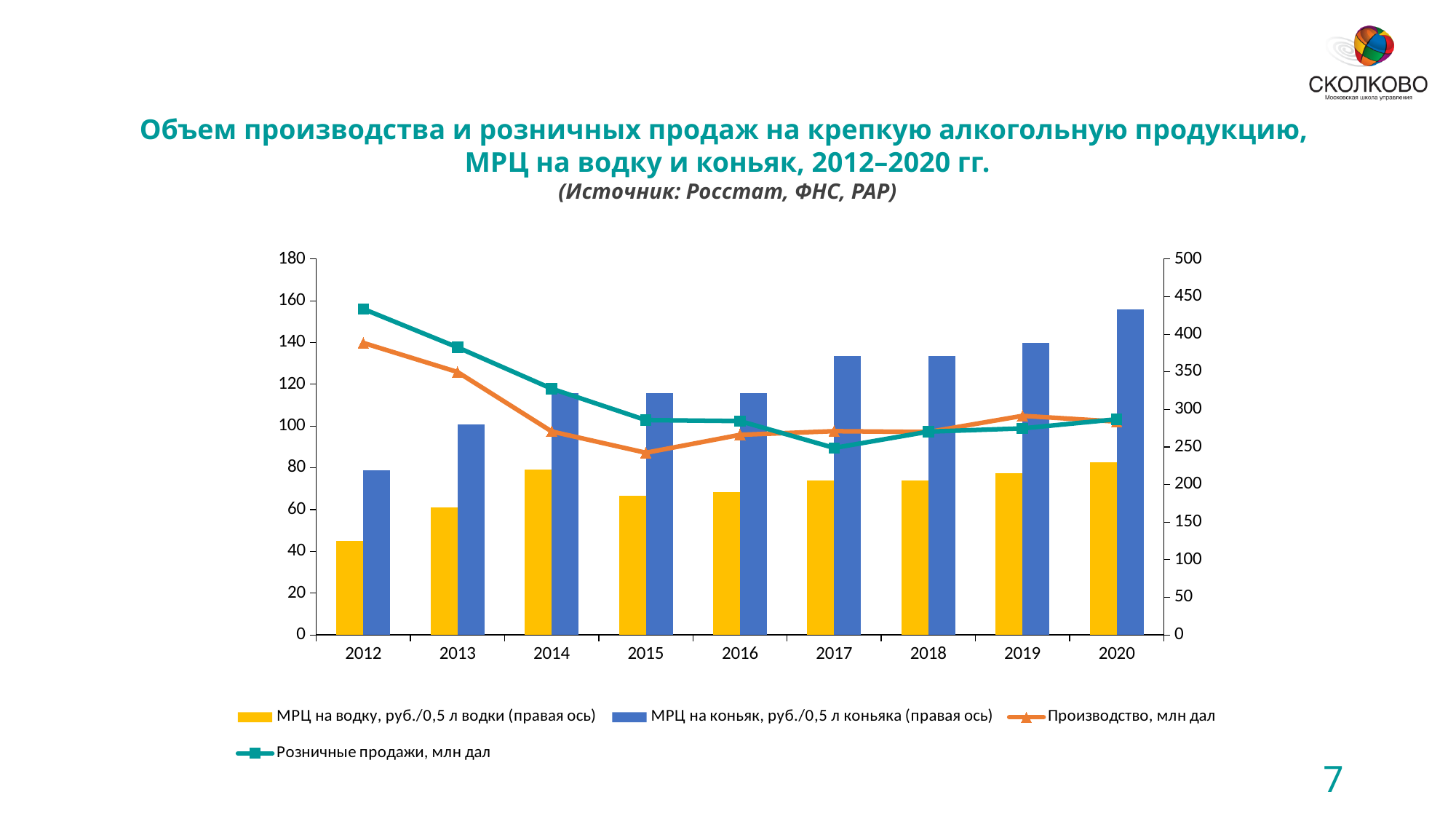
Is the value for 'МРЦ на коньяк' in 2020 greater or less than 400 on the right axis? greater In which year is the bar for 'МРЦ на водку, руб./0,5 л водки' the lowest? 2012 In which year does the 'Производство, млн дал' line reach its highest point? 2012 In which year is the bar for 'МРЦ на коньяк, руб./0,5 л коньяка' the highest? 2020 In which year does the 'Розничные продажи, млн дал' line reach its lowest point? 2017 In 2012, which is larger: 'Розничные продажи, млн дал' or 'Производство, млн дал'? Розничные продажи, млн дал Is the value for 'МРЦ на водку' in 2012 greater or less than 150 on the right axis? less According to the legend, which axis do the 'МРЦ на водку' and 'МРЦ на коньяк' series use? The right axis (правая ось) How many years are shown on the x axis? 9 Does the 'Розничные продажи, млн дал' line rise or fall from 2012 to 2017? Fall How many series does the legend list? 4 What kind of chart is shown on the slide? A combined bar and line chart